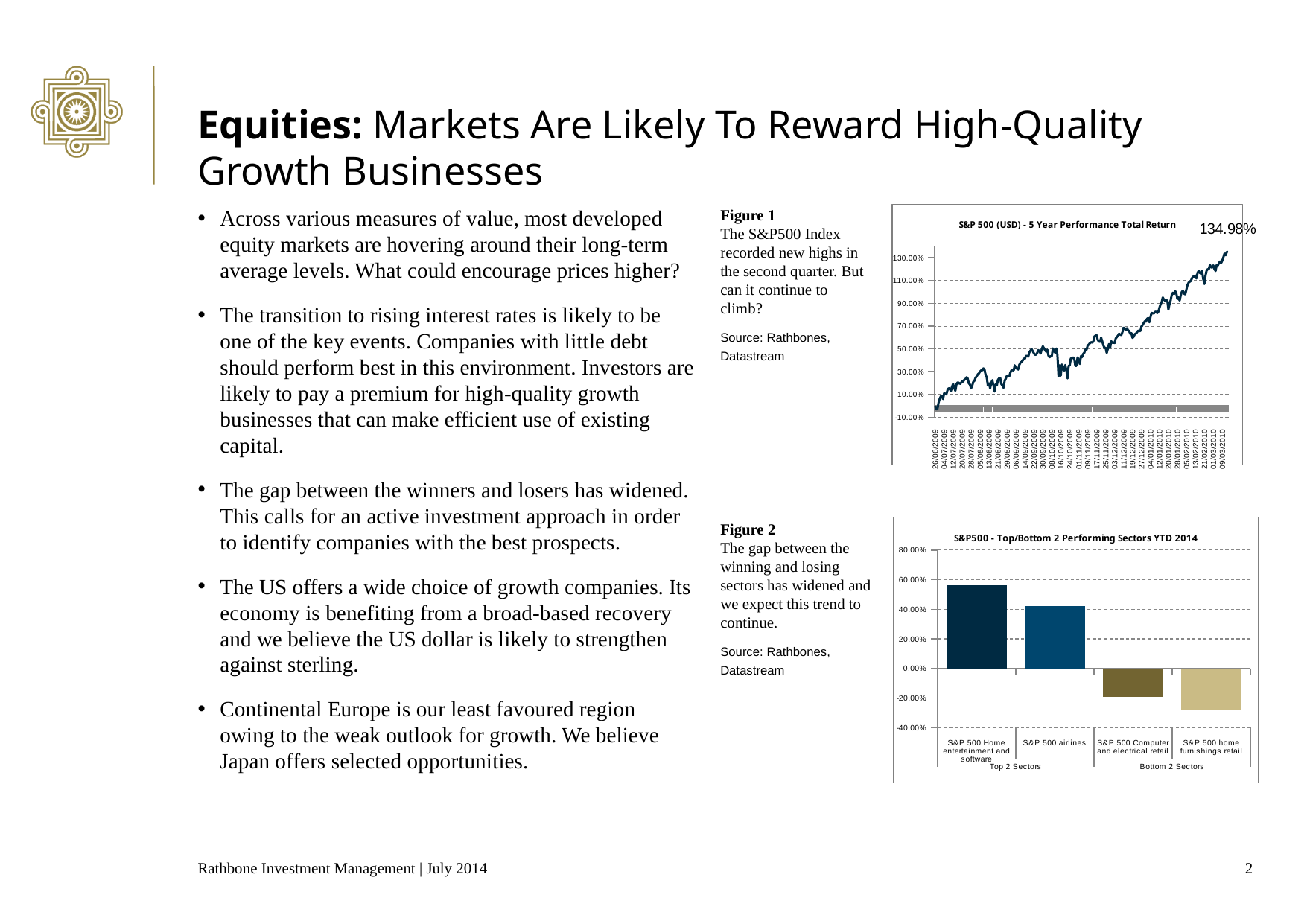
In Figure 2, what are the two group labels shown beneath the sector names on the x axis? Top 2 Sectors and Bottom 2 Sectors In Figure 1, what total return value is printed at the end of the S&P 500 line? 134.98% In Figure 2, which sector has the highest bar? S&P 500 Home entertainment and software What kind of chart is Figure 1, 'S&P 500 (USD) - 5 Year Performance Total Return'? Line chart In Figure 2, which is larger: the value for S&P 500 Home entertainment and software or the value for S&P 500 airlines? S&P 500 Home entertainment and software In Figure 2, which sector has the lowest bar? S&P 500 home furnishings retail In Figure 2, is the value for S&P 500 airlines greater or less than 60.00%? less In Figure 2, is the value for S&P 500 home furnishings retail greater or less than -20.00%? less In Figure 2, is the value for S&P 500 Home entertainment and software greater or less than 40.00%? greater How many sector bars are plotted in Figure 2? 4 In Figure 1, does the S&P 500 total return line generally rise or fall from left to right? Rise What kind of chart is Figure 2, 'S&P500 - Top/Bottom 2 Performing Sectors YTD 2014'? Bar chart